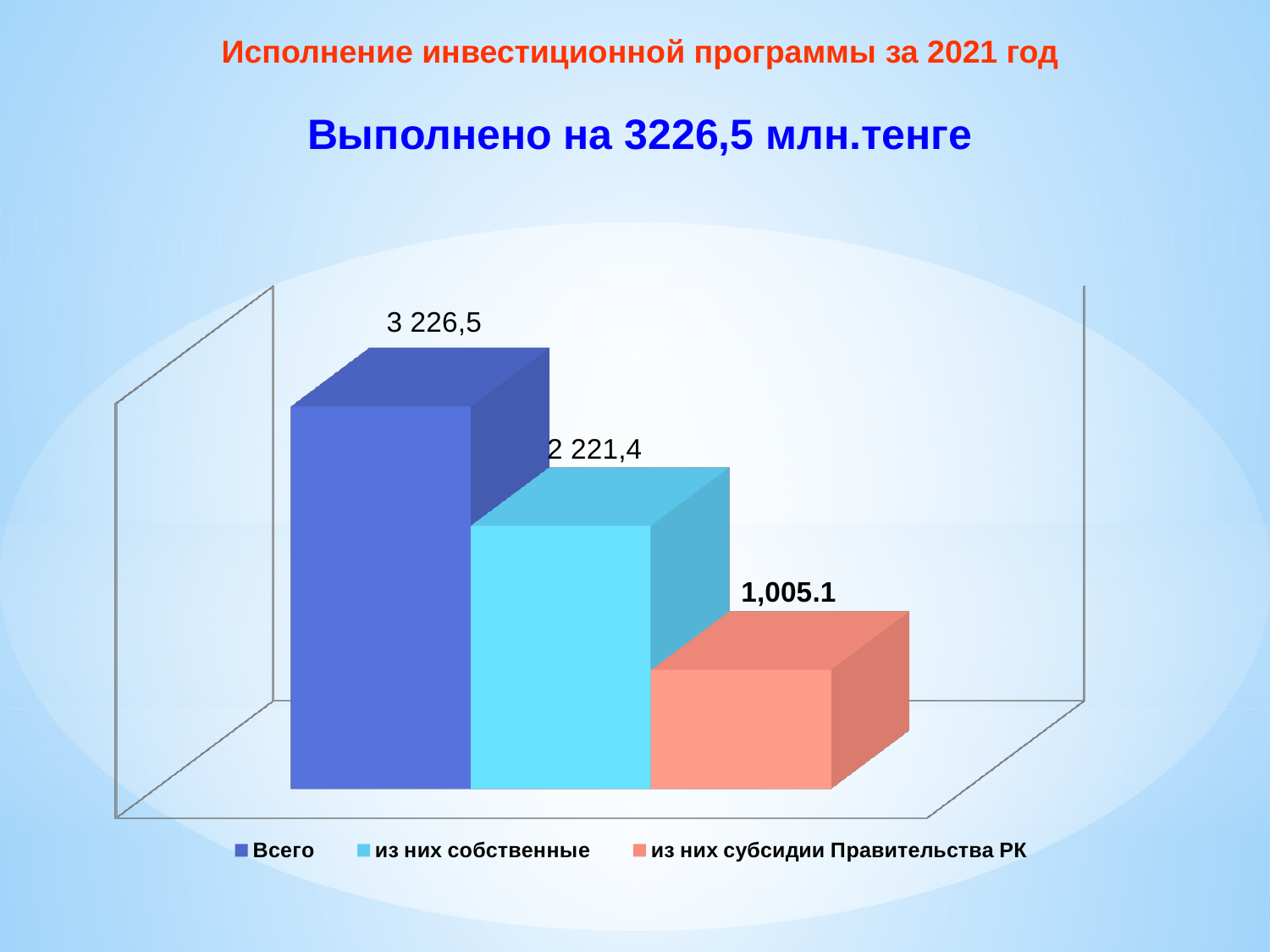
Which series has the highest value? Всего How many series does the legend list? 3 What is the title at the top of the slide? Исполнение инвестиционной программы за 2021 год What is the value of the bar for из них субсидии Правительства РК? 1,005.1 Which is larger: из них собственные or из них субсидии Правительства РК? из них собственные Which series has the lowest value? из них субсидии Правительства РК What is the value of the Всего bar? 3 226,5 What is the value of the bar for из них собственные? 2 221,4 Do the bar values rise or fall from left to right? fall What colour is the bar for из них субсидии Правительства РК? salmon/orange What kind of chart is shown on the slide? bar chart How many bars are plotted on the chart? 3